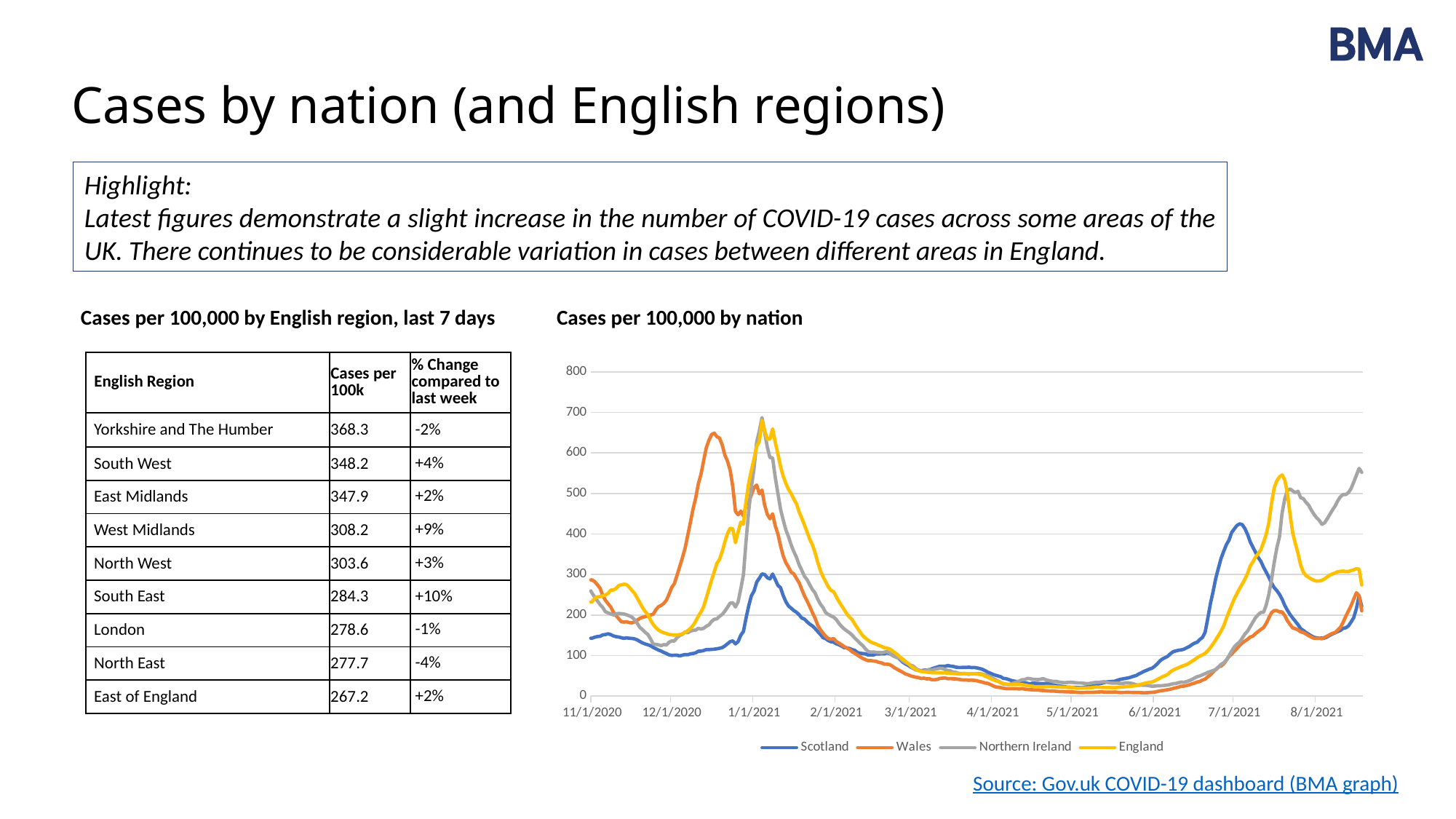
In the 'Cases per 100,000 by nation' chart, is the peak value for Wales in December 2020 greater or less than 600? greater In the 'Cases per 100,000 by nation' chart, is the peak value for Northern Ireland in January 2021 greater or less than 600? greater In the 'Cases per 100,000 by nation' chart, which nation had the highest peak in December 2020? Wales In the 'Cases per 100,000 by nation' chart, does the Wales line rise or fall between 1/1/2021 and 4/1/2021? fall In the 'Cases per 100,000 by nation' chart, is the peak value for England in late July 2021 greater or less than 500? greater In the 'Cases per 100,000 by nation' chart, what colour is the Scotland line? blue How many series does the legend of the 'Cases per 100,000 by nation' chart list? 4 What kind of chart is 'Cases per 100,000 by nation'? line chart In the 'Cases per 100,000 by nation' chart, which nation has the highest value at the right-hand end of the chart? Northern Ireland In the 'Cases per 100,000 by nation' chart, around 7/1/2021, which is higher: Scotland or Wales? Scotland Which nations are listed in the legend of the 'Cases per 100,000 by nation' chart? Scotland, Wales, Northern Ireland, England